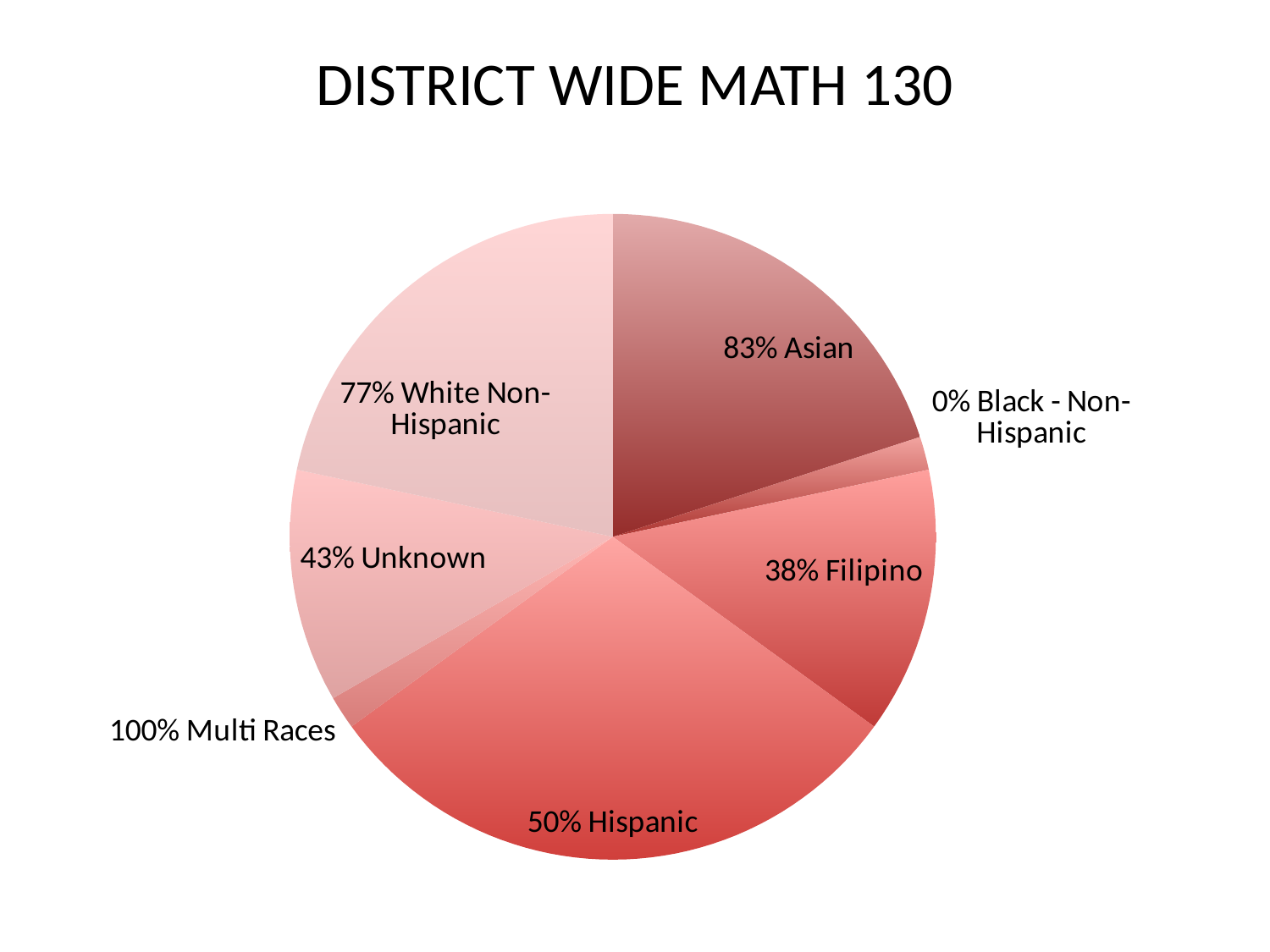
What is the title of the chart? DISTRICT WIDE MATH 130 Which slice is larger by area, the Asian slice or the Filipino slice? Asian What percentage is printed in the label for the Multi Races slice? 100% What percentage is printed in the label for the Black - Non-Hispanic slice? 0% What percentage is printed in the label for the White Non-Hispanic slice? 77% What percentage is printed in the label for the Asian slice? 83% What percentage is printed in the label for the Filipino slice? 38% What kind of chart is shown on the slide? pie chart What percentage is printed in the label for the Hispanic slice? 50% What percentage is printed in the label for the Unknown slice? 43% How many slices does the pie chart have? 7 Which slice of the pie is the largest by area? Hispanic